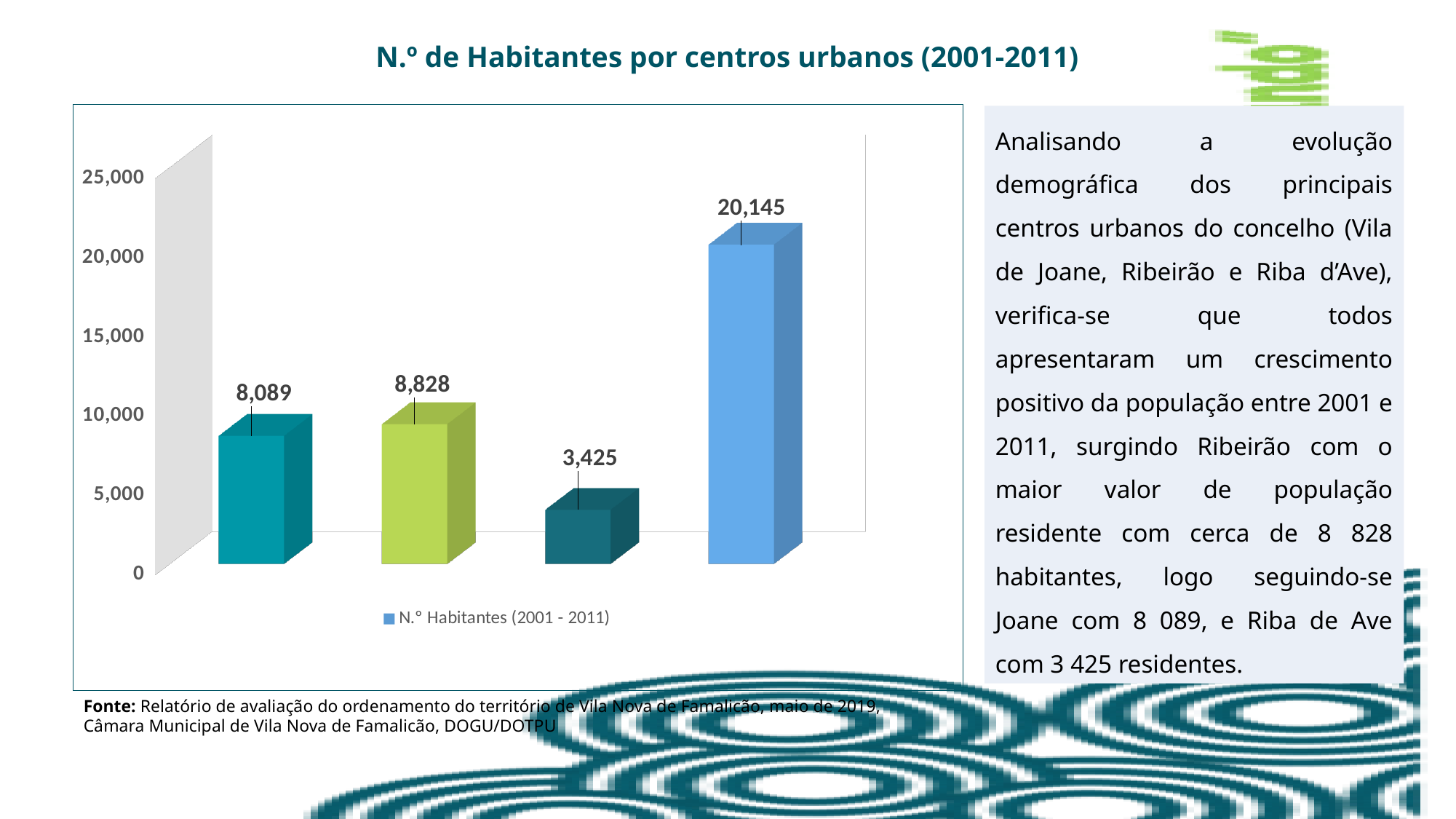
What is the title of the chart? N.º de Habitantes por centros urbanos (2001-2011) What is the value shown on the second bar (the light green one)? 8,828 What is the value shown on the fourth (rightmost, light blue) bar? 20,145 What is the difference between the value of the fourth bar and the value of the second bar? 11,317 What kind of chart is shown on the slide? bar chart What is the value shown on the third bar (the dark teal one)? 3,425 Which bar has the lowest value? the third bar (3,425) Is the value of the third bar greater or less than 5,000? less Which bar has the highest value? the fourth bar (20,145) How many bars are plotted in the chart? 4 What is the value shown on the first (leftmost) bar? 8,089 How many series does the chart legend list? 1